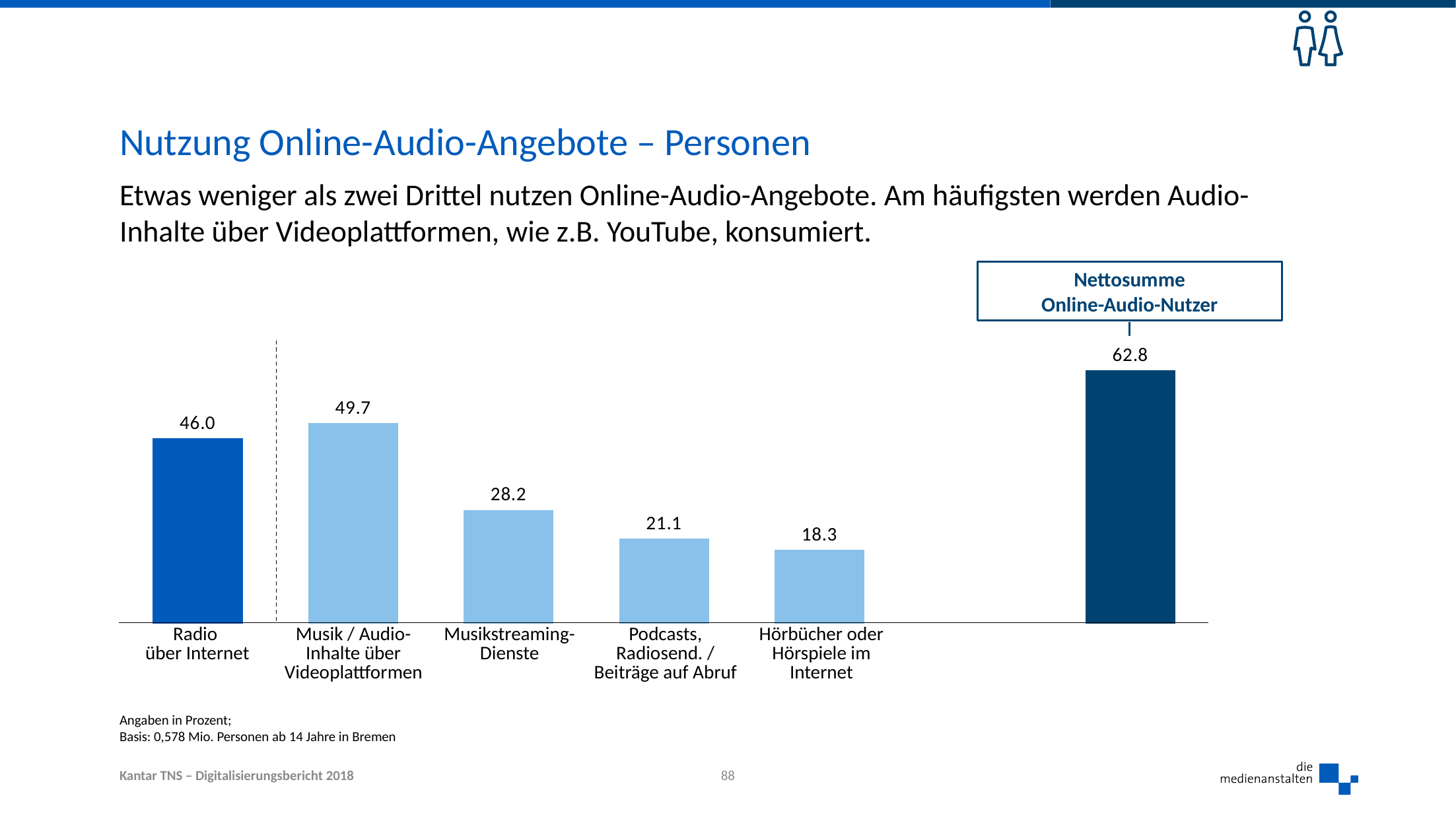
How many bars are shown in the chart, including the Nettosumme bar? 6 What is the value of the Nettosumme Online-Audio-Nutzer bar? 62.8 What is the value for Musik / Audio-Inhalte über Videoplattformen? 49.7 Which is larger, the value for Musikstreaming-Dienste or the value for Podcasts, Radiosend. / Beiträge auf Abruf? Musikstreaming-Dienste What is the value for Podcasts, Radiosend. / Beiträge auf Abruf? 21.1 What kind of chart is shown on the slide? Bar chart What is the value for Musikstreaming-Dienste? 28.2 What is the value for Radio über Internet? 46.0 What is the difference between the values for Musik / Audio-Inhalte über Videoplattformen and Radio über Internet? 3.7 Which category has the lowest value? Hörbücher oder Hörspiele im Internet What is the value for Hörbücher oder Hörspiele im Internet? 18.3 Which of the five individual online audio offerings has the highest value? Musik / Audio-Inhalte über Videoplattformen